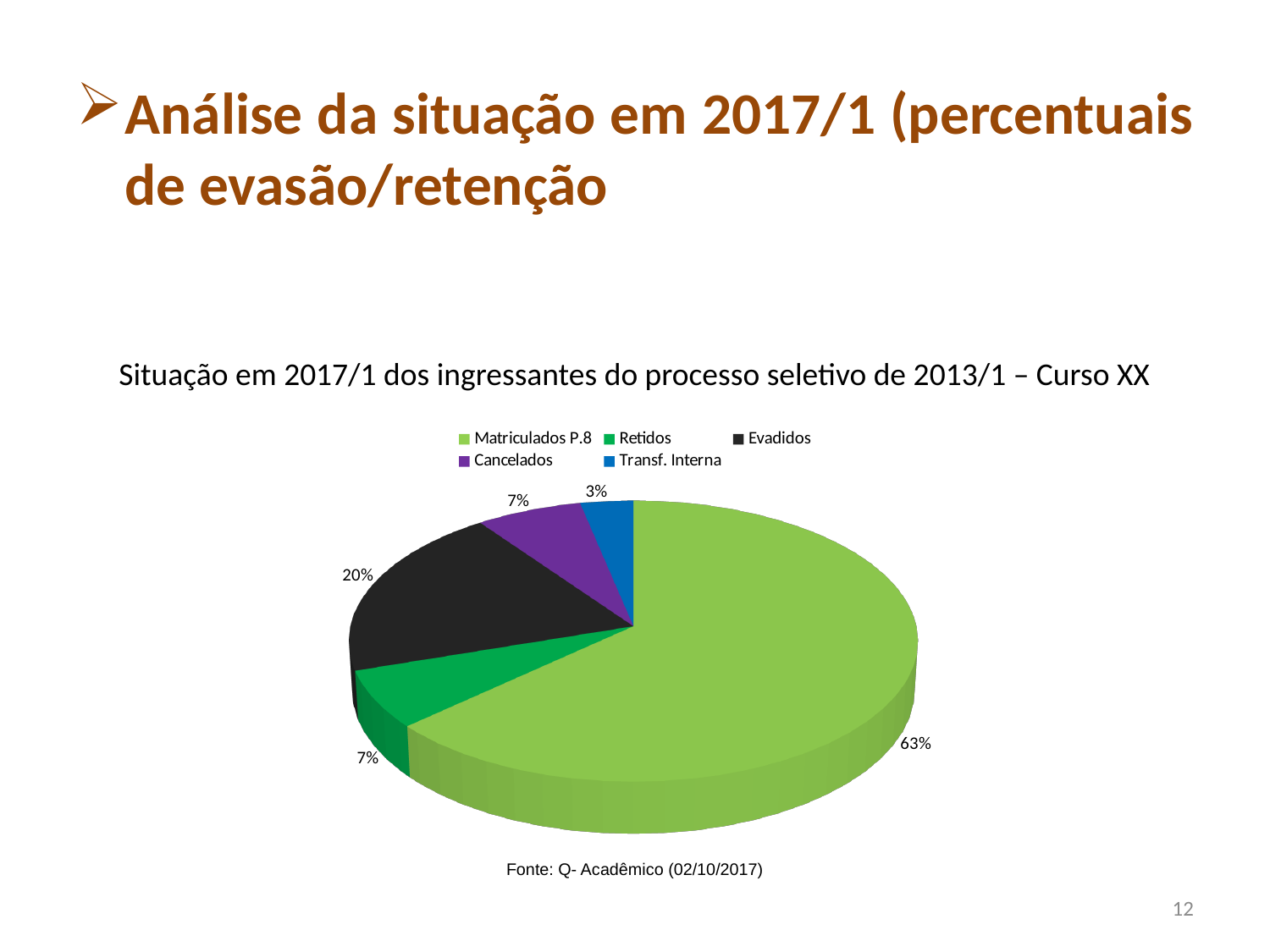
How many categories does the legend list? 5 What percentage of the pie is Evadidos? 20% Which is larger, the share for Evadidos or the share for Retidos? Evadidos What is the title of the chart? Situação em 2017/1 dos ingressantes do processo seletivo de 2013/1 – Curso XX What percentage of the pie is Cancelados? 7% What percentage of the pie is Matriculados P.8? 63% What is the difference in percentage points between Matriculados P.8 and Evadidos? 43 Which category has the largest share of the pie? Matriculados P.8 Which category has the smallest share of the pie? Transf. Interna What colour is the Evadidos slice? Black What kind of chart is shown on the slide? Pie chart What percentage of the pie is Transf. Interna? 3%